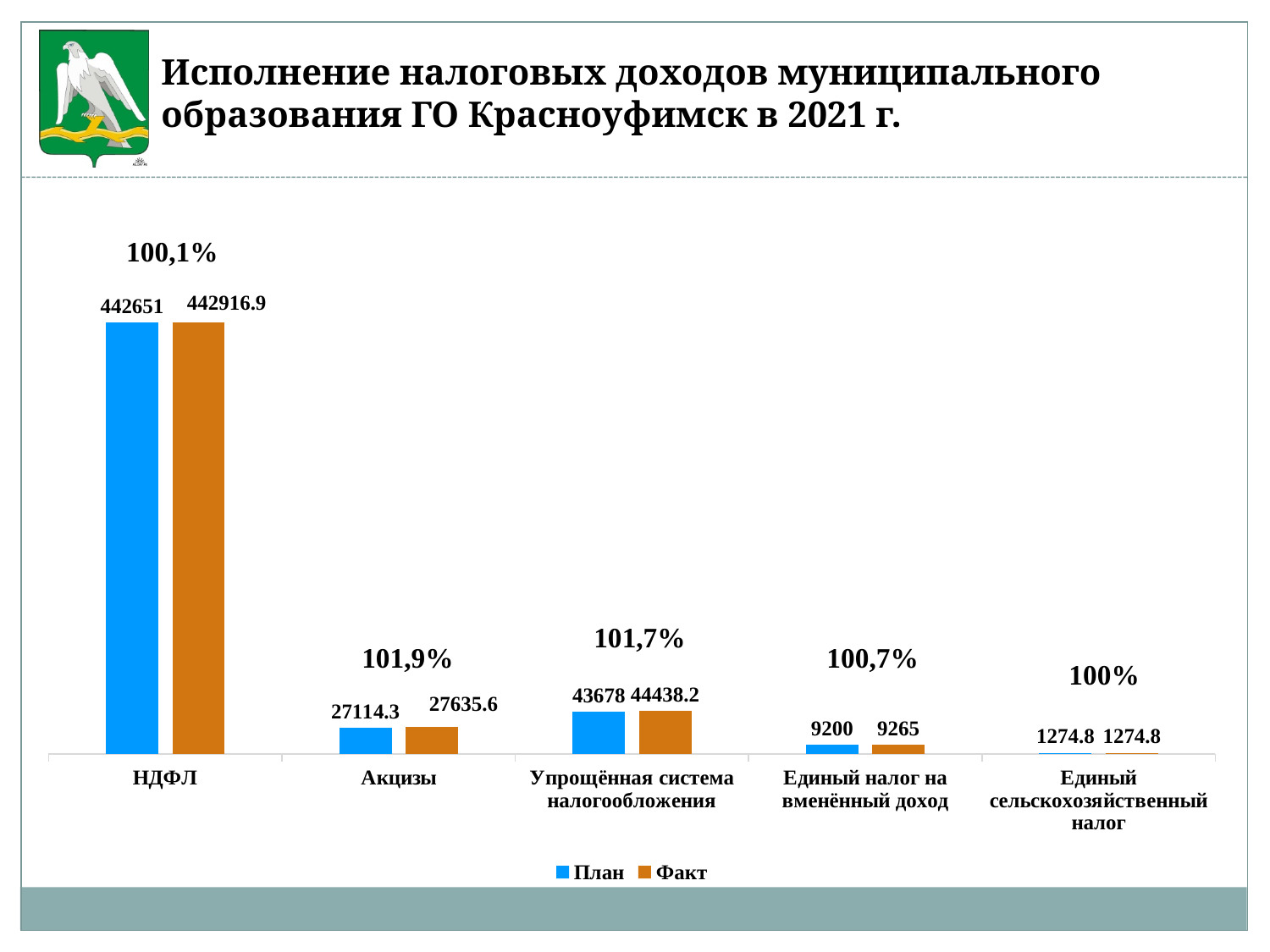
What is the План value for Единый налог на вменённый доход? 9200 What type of chart is shown on the slide? bar chart How many series does the legend list? 2 What is the Факт value for Акцизы? 27635.6 What is the Факт value for Упрощённая система налогообложения? 44438.2 Which category has the highest Факт value? НДФЛ What is the difference between the Факт and План values for Акцизы? 521.3 What percentage is printed above the bars for Единый налог на вменённый доход? 100,7% Which is larger for Упрощённая система налогообложения, the План value or the Факт value? Факт Which category has the lowest План value? Единый сельскохозяйственный налог What is the План value for НДФЛ? 442651 How many categories are shown on the x axis? 5